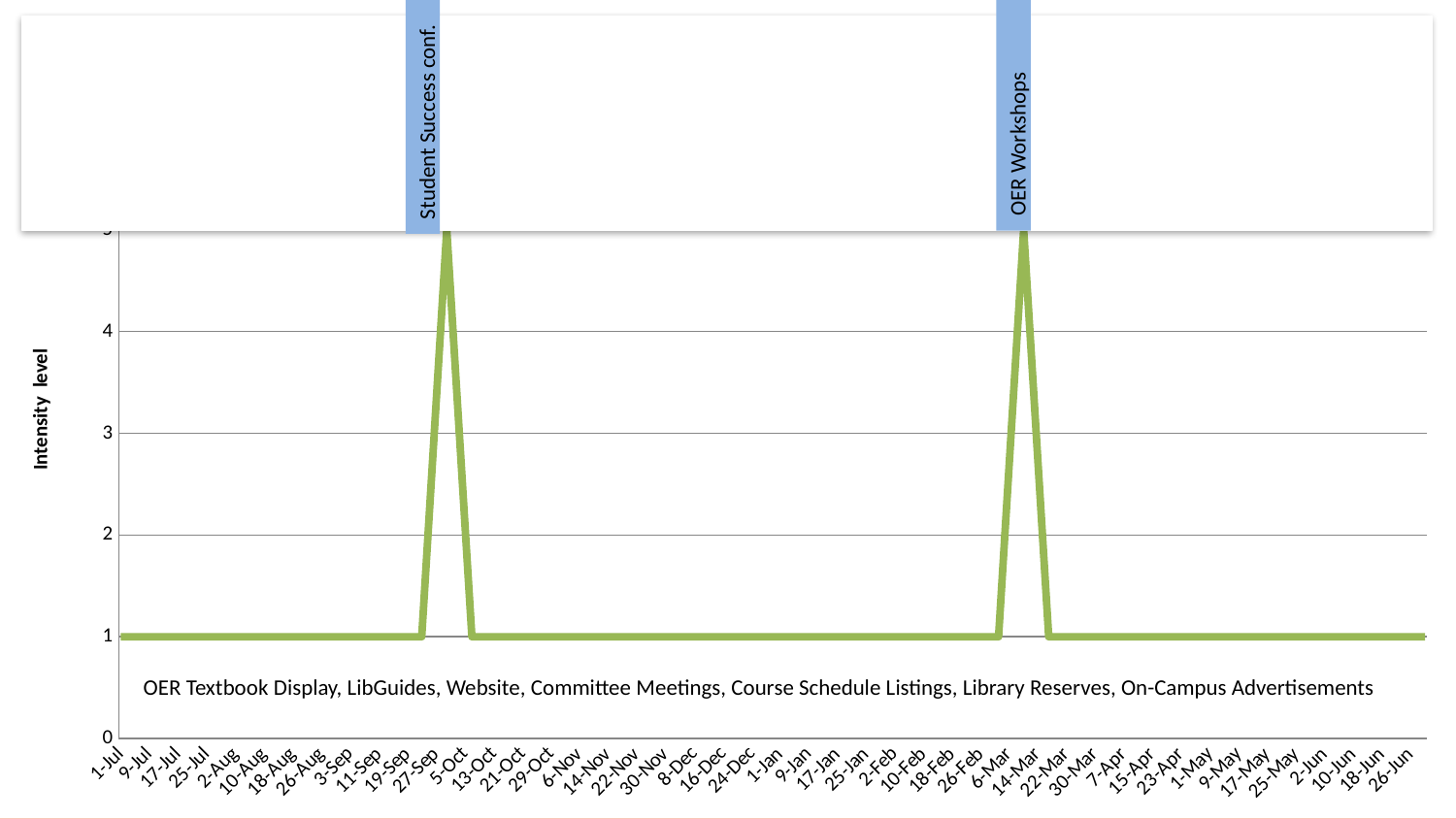
Is the peak of the spike labeled 'Student Success conf.' greater or less than 4? greater Is the intensity level on 8-Dec greater or less than 2? less Which event label is attached to the spike in March? OER Workshops What kind of chart is shown on the slide? line chart Between 13-Oct and 26-Feb, does the line rise, fall, or stay flat? stay flat What is the title of the vertical axis? Intensity level What is the first date shown on the x axis? 1-Jul Which is larger: the intensity level at the peak labeled 'OER Workshops' or the intensity level on 26-Jun? the peak labeled OER Workshops What is the lowest intensity level the line reaches? 1 What is the intensity level on 1-Jan? 1 How many spikes above the baseline does the line show? 2 What is the intensity level on 1-Jul? 1